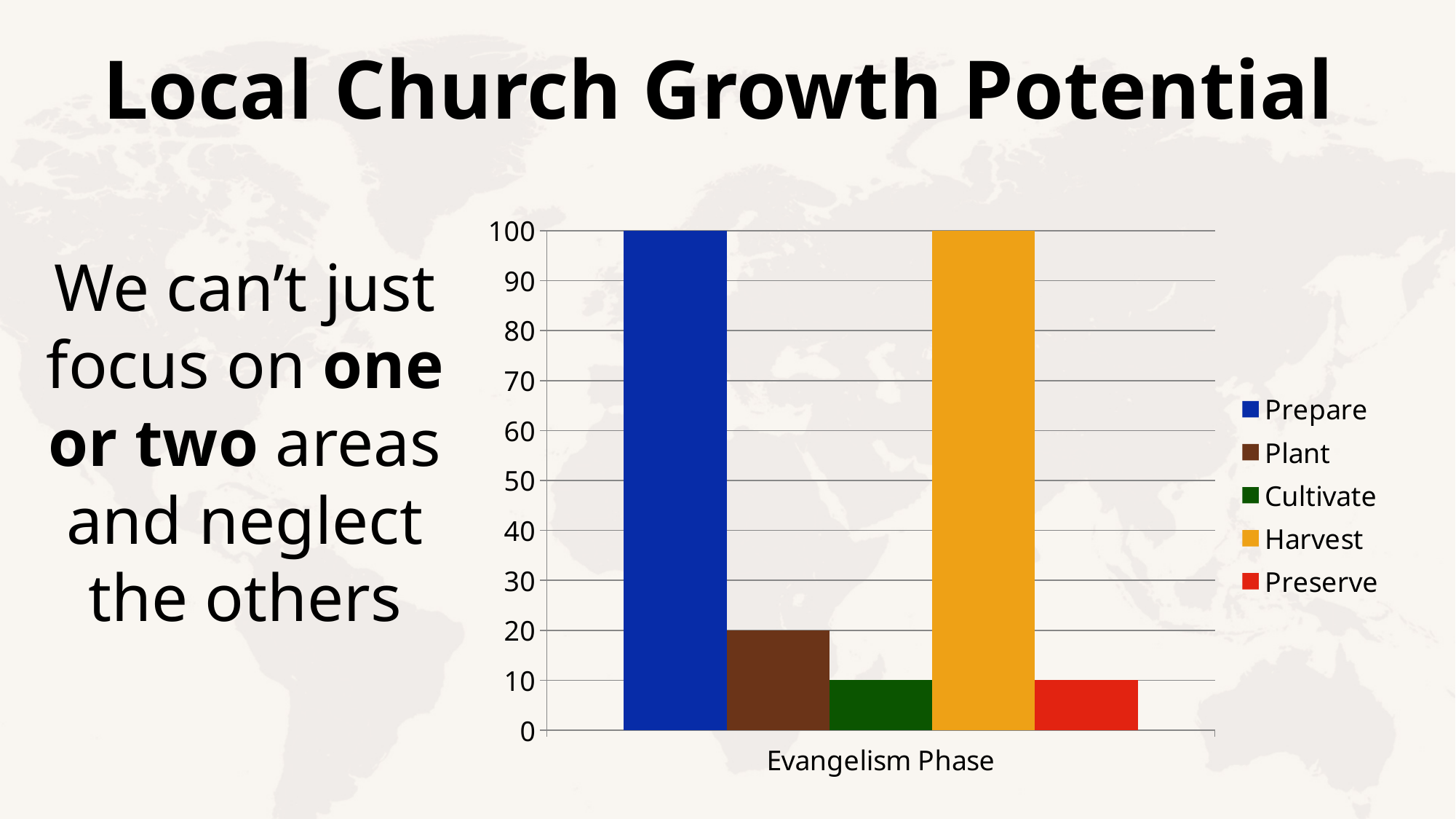
Is the value for Plant greater or less than 50? less What is the value of the Cultivate bar? 10 What is the label on the x axis of the chart? Evangelism Phase What is the value of the Preserve bar? 10 How many categories are shown on the x axis? 1 What is the value of the Prepare bar? 100 What kind of chart is shown on the slide? Bar chart What is the value of the Harvest bar? 100 How many series does the legend list? 5 What is the difference between the Prepare and Plant values? 80 Which is larger, the Plant value or the Preserve value? Plant What is the value of the Plant bar? 20